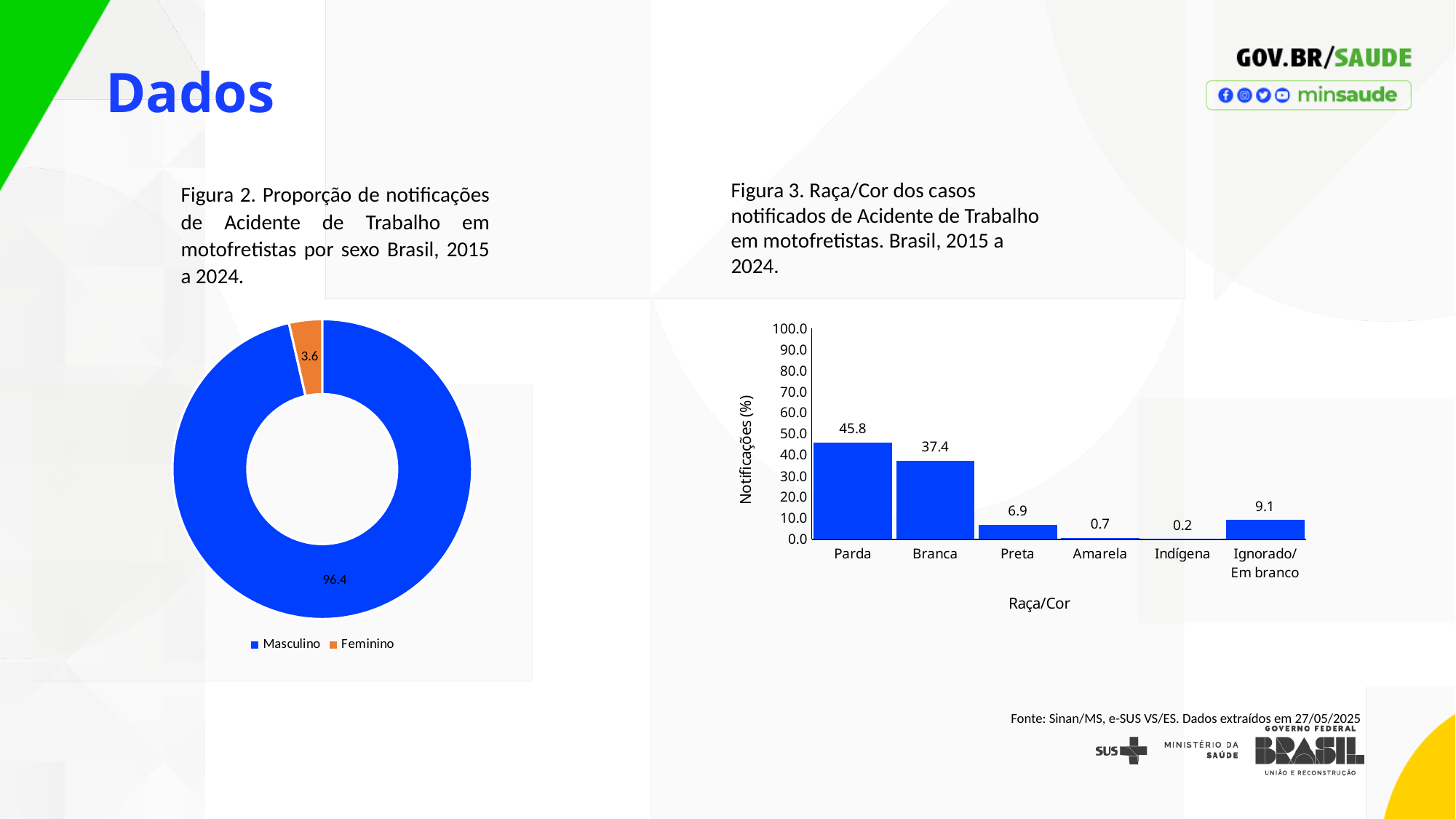
In Figura 3 (the bar chart on the right), what is the value for Ignorado/Em branco? 9.1 In Figura 2 (the doughnut chart on the left), what is the value shown for Masculino? 96.4 What kind of chart is Figura 3 (the chart on the right)? Bar chart In Figura 3 (the bar chart on the right), which Raça/Cor category has the lowest value? Indígena In Figura 2 (the doughnut chart on the left), which category has the larger share, Masculino or Feminino? Masculino In Figura 3 (the bar chart on the right), what is the value for Parda? 45.8 In Figura 3 (the bar chart on the right), what is the difference between the values for Parda and Branca? 8.4 In Figura 2 (the doughnut chart on the left), what colour is the Feminino slice? Orange In Figura 3 (the bar chart on the right), which Raça/Cor category has the highest value? Parda In Figura 3 (the bar chart on the right), how many Raça/Cor categories are shown on the x axis? 6 In Figura 2 (the doughnut chart on the left), how many entries does the legend list? 2 In Figura 2 (the doughnut chart on the left), what is the value shown for Feminino? 3.6